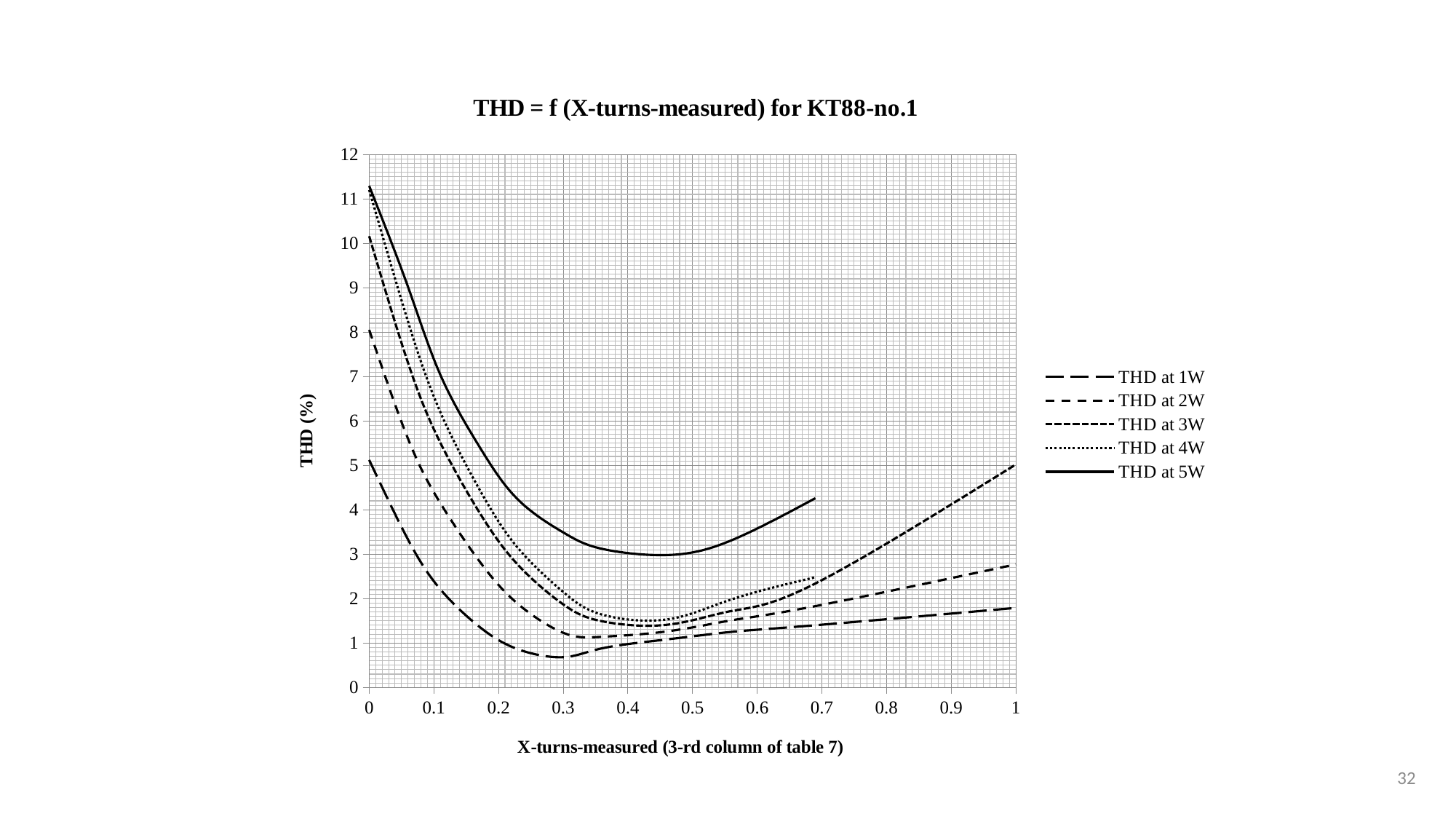
Is the value of THD at 5W at X-turns-measured = 0 greater or less than 10? greater Which series has the lowest THD at X-turns-measured = 0? THD at 1W At X-turns-measured = 1, which is higher, THD at 3W or THD at 2W? THD at 3W Is the value of THD at 5W at X-turns-measured = 0.5 greater or less than 2? greater Is the value of THD at 1W at X-turns-measured = 1 greater or less than 2? less Does the THD at 5W line rise or fall as X-turns-measured goes from 0 to 0.4? fall How many series does the legend list? 5 What is the label of the vertical axis? THD (%) What kind of chart is shown on the slide? line chart What is the title of the chart? THD = f (X-turns-measured) for KT88-no.1